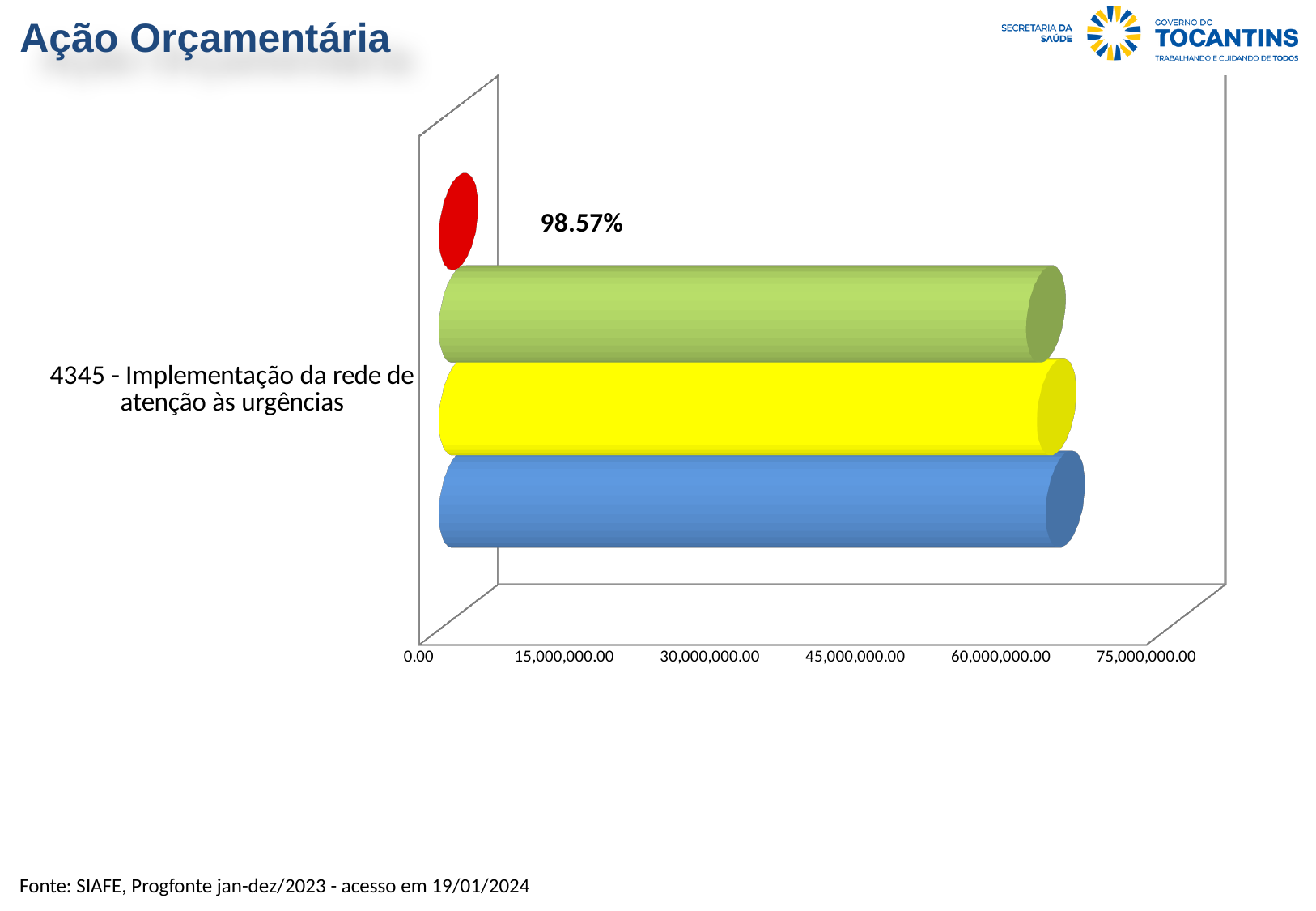
What is the category label shown on the chart? 4345 - Implementação da rede de atenção às urgências Which colour bar has the lowest value on the chart? red Is the value of the blue bar greater or less than 60,000,000.00? greater Is the value of the red bar greater or less than 15,000,000.00? less What is the highest tick value shown on the horizontal axis? 75,000,000.00 Which bar is shorter, the red bar or the blue bar? the red bar How many categories are shown on the vertical axis of the chart? 1 What kind of chart is shown on the slide? bar chart Is the value of the yellow bar greater or less than 45,000,000.00? greater What percentage value is printed as a data label on the chart? 98.57%